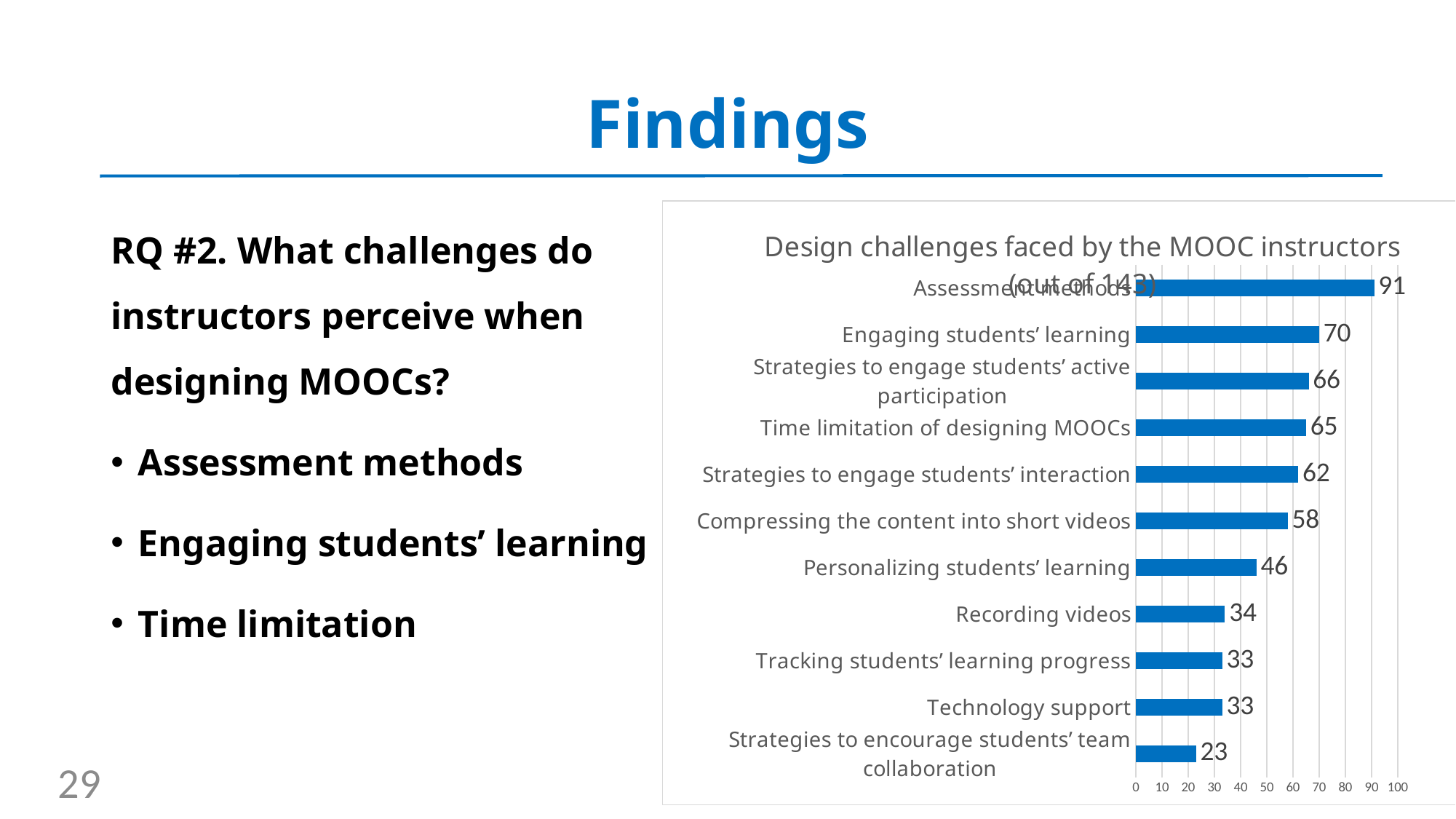
What value is shown for Strategies to encourage students' team collaboration? 23 Which is larger, the value for Compressing the content into short videos or the value for Recording videos? Compressing the content into short videos What value is shown for Assessment methods? 91 How many design challenges are plotted in the chart? 11 What is the total of the values for Tracking students' learning progress and Technology support? 66 Which design challenge has the lowest value? Strategies to encourage students' team collaboration What value is shown for Time limitation of designing MOOCs? 65 Which design challenge has the highest value? Assessment methods What value is shown for Personalizing students' learning? 46 Is the value for Strategies to engage students' interaction greater or less than 50? greater What kind of chart is shown on the slide? Bar chart What is the difference between the values for Assessment methods and Engaging students' learning? 21